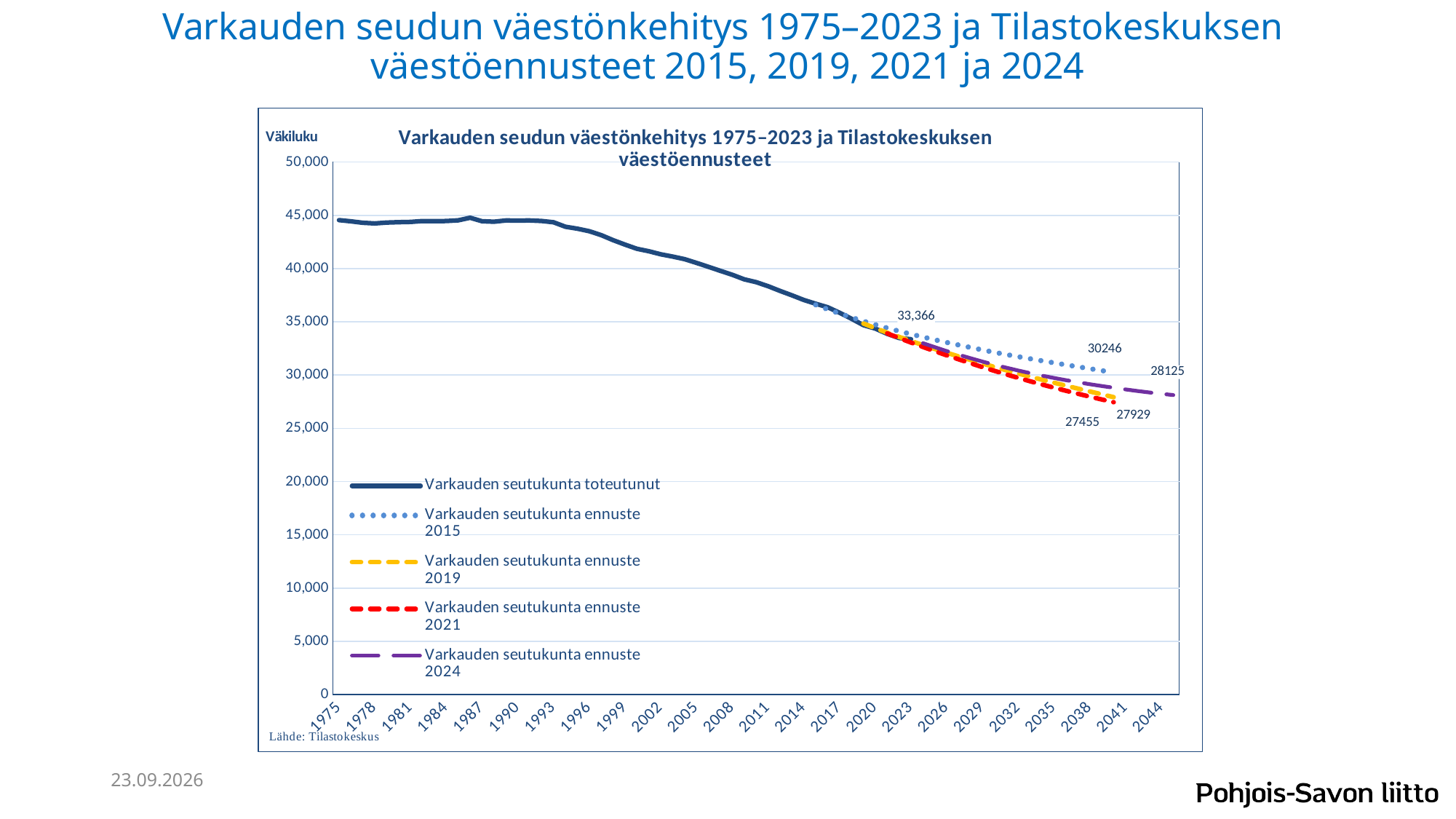
What is the labelled end value of the 'Varkauden seutukunta ennuste 2019' series? 27929 Which forecast series ends at the highest labelled value? Varkauden seutukunta ennuste 2015 What is the labelled end value of the 'Varkauden seutukunta ennuste 2015' series? 30246 Is the actual population (toteutunut) in 1975 greater or less than 40,000? greater What is the labelled end value of the 'Varkauden seutukunta ennuste 2024' series? 28125 What is the difference between the labelled end values of the 2015 forecast (30246) and the 2021 forecast (27455)? 2791 What kind of chart is shown on the slide? line chart Which ends at a larger labelled value, the 2019 forecast or the 2021 forecast? Varkauden seutukunta ennuste 2019 What is the label on the vertical axis of the chart? Väkiluku Which forecast series ends at the lowest labelled value? Varkauden seutukunta ennuste 2021 What is the labelled end value of the 'Varkauden seutukunta ennuste 2021' series? 27455 How many series does the legend list? 5